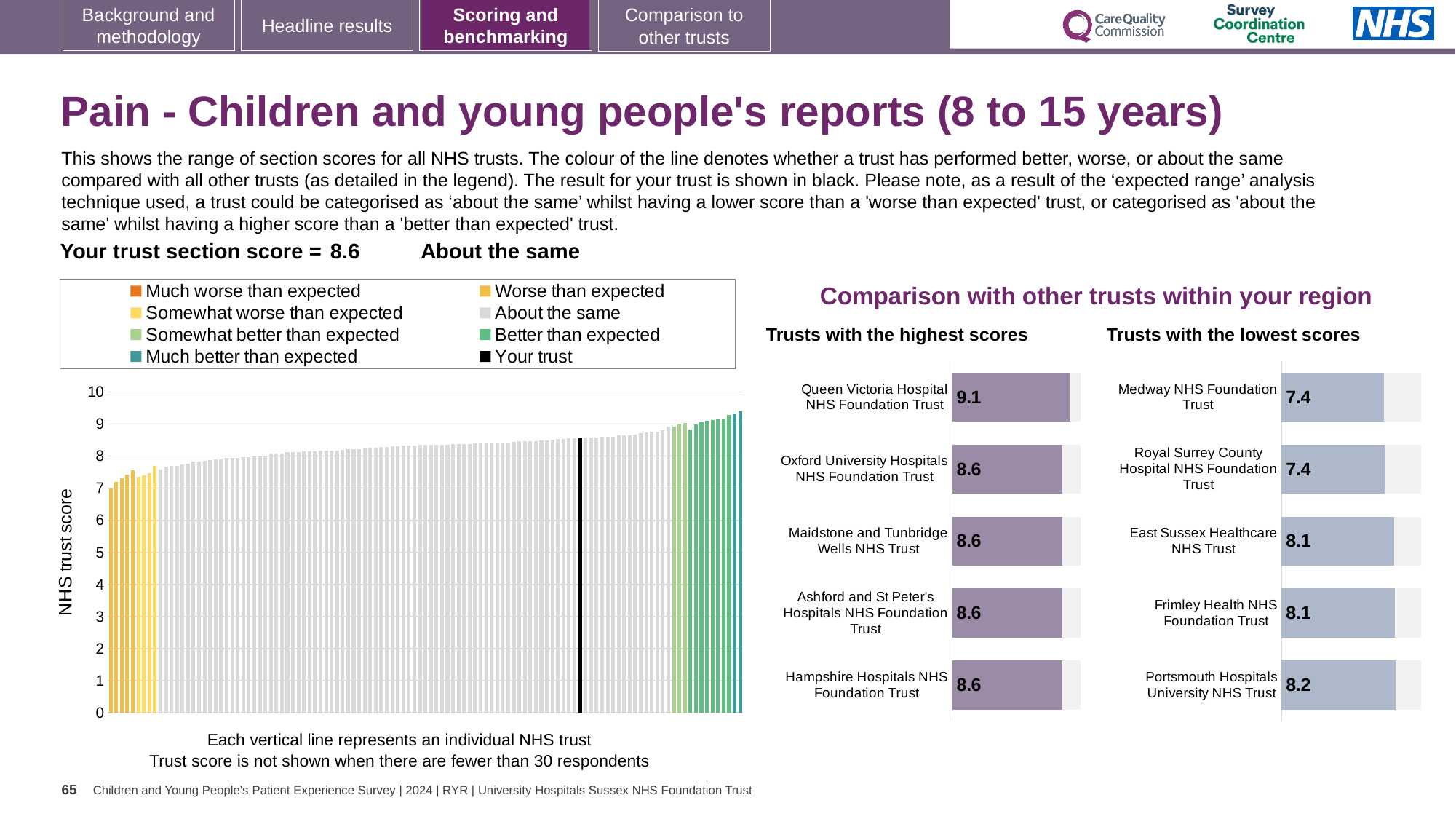
In the 'Trusts with the lowest scores' chart, what is the score for Portsmouth Hospitals University NHS Trust? 8.2 In the 'Trusts with the highest scores' chart, what is the score for Queen Victoria Hospital NHS Foundation Trust? 9.1 How many entries does the legend of the large 'NHS trust score' chart on the left list? 8 In the 'Trusts with the lowest scores' chart, which trust has the highest score shown? Portsmouth Hospitals University NHS Trust In the large 'NHS trust score' chart on the left, is the value of the black 'Your trust' bar greater or less than 8? greater In the 'Trusts with the highest scores' chart, which trust has the highest score? Queen Victoria Hospital NHS Foundation Trust In the 'Trusts with the lowest scores' chart, which has the larger score: East Sussex Healthcare NHS Trust or Medway NHS Foundation Trust? East Sussex Healthcare NHS Trust What kind of chart is the large 'NHS trust score' chart on the left of the slide? Bar chart How many trusts are listed in the 'Trusts with the lowest scores' chart? 5 In the 'Trusts with the highest scores' chart, what is the difference between the score for Queen Victoria Hospital NHS Foundation Trust and the score for Oxford University Hospitals NHS Foundation Trust? 0.5 In the 'Trusts with the lowest scores' chart, what is the difference between the score for Portsmouth Hospitals University NHS Trust and the score for Medway NHS Foundation Trust? 0.8 In the large 'NHS trust score' chart on the left, do the bar values rise or fall from left to right along the x axis? Rise